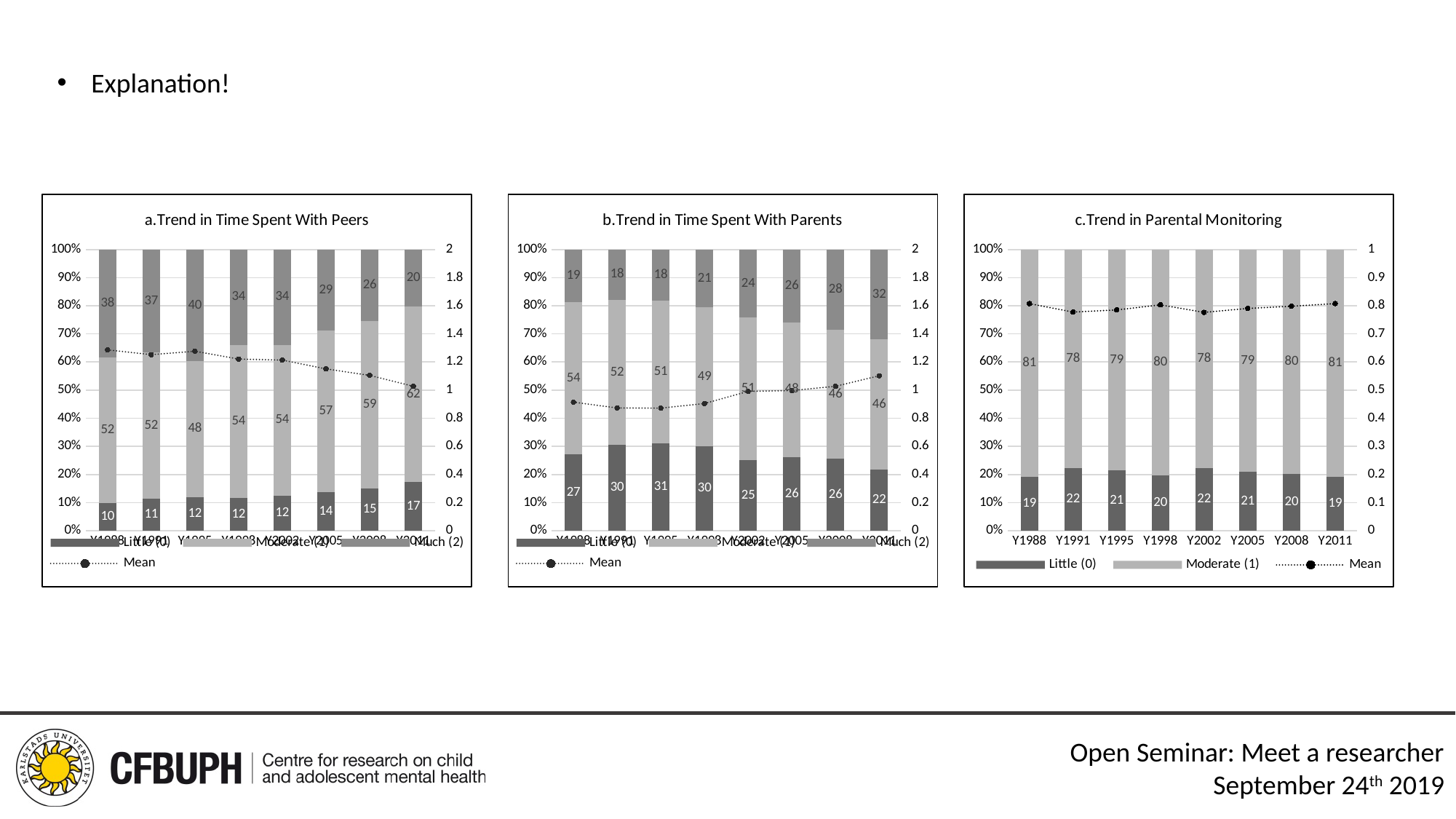
In the chart 'b.Trend in Time Spent With Parents', what is the value of the Little (0) segment in the first (leftmost) bar? 27 How many bars (years) are shown in the chart 'c.Trend in Parental Monitoring'? 8 In the chart 'b.Trend in Time Spent With Parents', in the last (rightmost) bar, which is larger: the Little (0) segment or the Much (2) segment? Much (2) In the chart 'b.Trend in Time Spent With Parents', does the Much (2) segment rise or fall from the first bar to the last bar? rise In the chart 'a.Trend in Time Spent With Peers', does the Much (2) segment rise or fall from the first bar to the last bar? fall What kind of chart is 'a.Trend in Time Spent With Peers'? Stacked bar chart with a line (Mean) In the chart 'c.Trend in Parental Monitoring', what is the value of the Little (0) segment for Y1991? 22 In the chart 'c.Trend in Parental Monitoring', what is the value of the Moderate (1) segment for Y2011? 81 In the chart 'a.Trend in Time Spent With Peers', what is the value of the Much (2) segment in the last (rightmost) bar? 20 In the chart 'a.Trend in Time Spent With Peers', what is the difference between the Moderate (1) and Little (0) values in the last (rightmost) bar? 45 How many series does the legend of the chart 'c.Trend in Parental Monitoring' list? 3 In the chart 'c.Trend in Parental Monitoring', is the Mean value for Y1988 (read on the right axis) greater or less than 0.7? greater